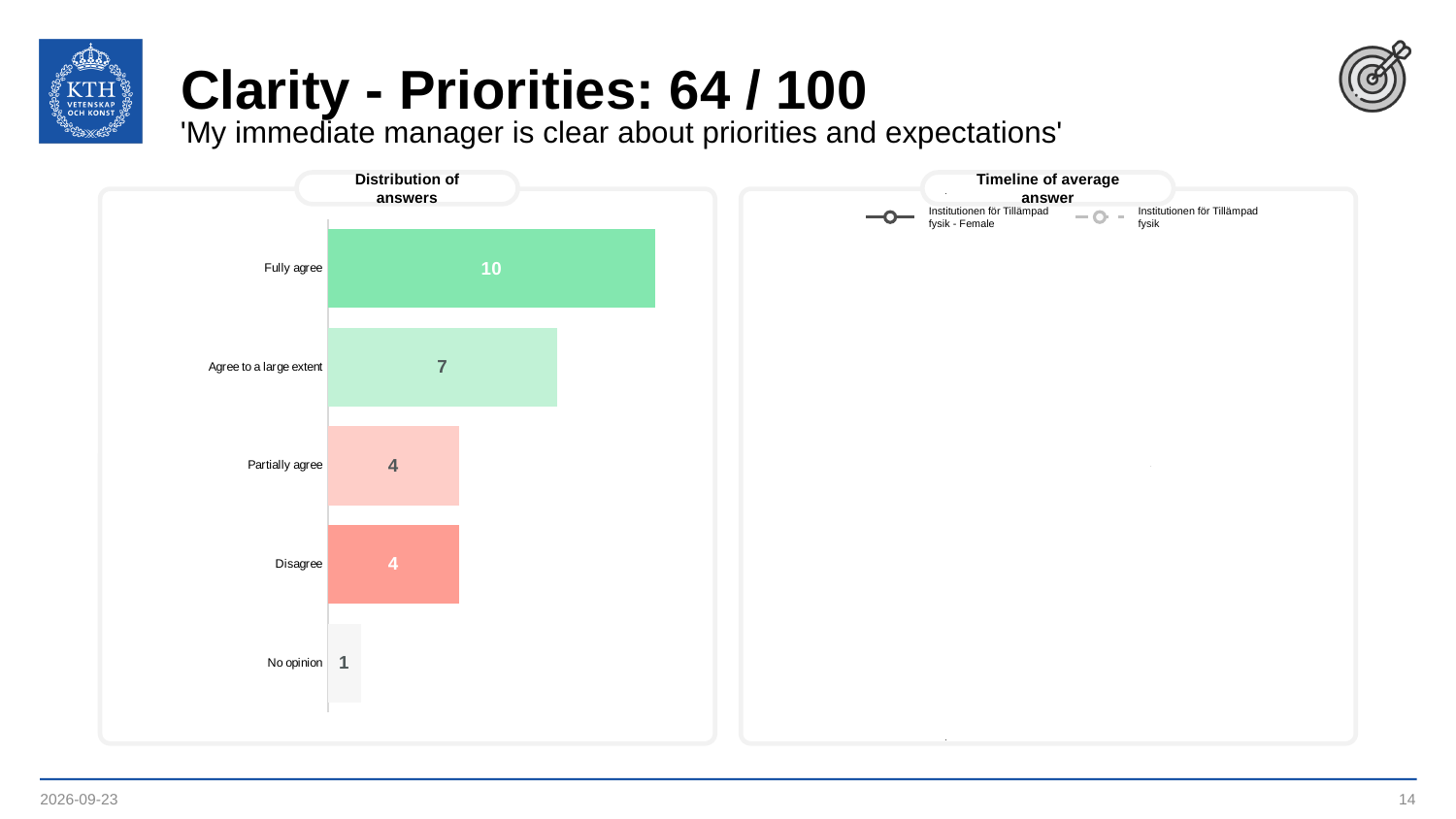
In the 'Distribution of answers' chart, which answer category has the highest value? Fully agree In the 'Distribution of answers' chart, how many respondents chose 'Fully agree'? 10 In the 'Distribution of answers' chart, which answer category has the lowest value? No opinion How many answer categories are shown in the 'Distribution of answers' chart? 5 In the 'Distribution of answers' chart, what is the value for 'Partially agree'? 4 In the 'Distribution of answers' chart, what is the value for 'No opinion'? 1 In the 'Distribution of answers' chart, what is the value for 'Agree to a large extent'? 7 How many series does the legend of the 'Timeline of average answer' chart list? 2 In the 'Distribution of answers' chart, what is the difference between the values for 'Fully agree' and 'Agree to a large extent'? 3 In the 'Distribution of answers' chart, which is larger: the value for 'Agree to a large extent' or the value for 'Disagree'? Agree to a large extent What kind of chart is the 'Distribution of answers' chart? Bar chart In the 'Distribution of answers' chart, what colour is the 'Disagree' bar? Red